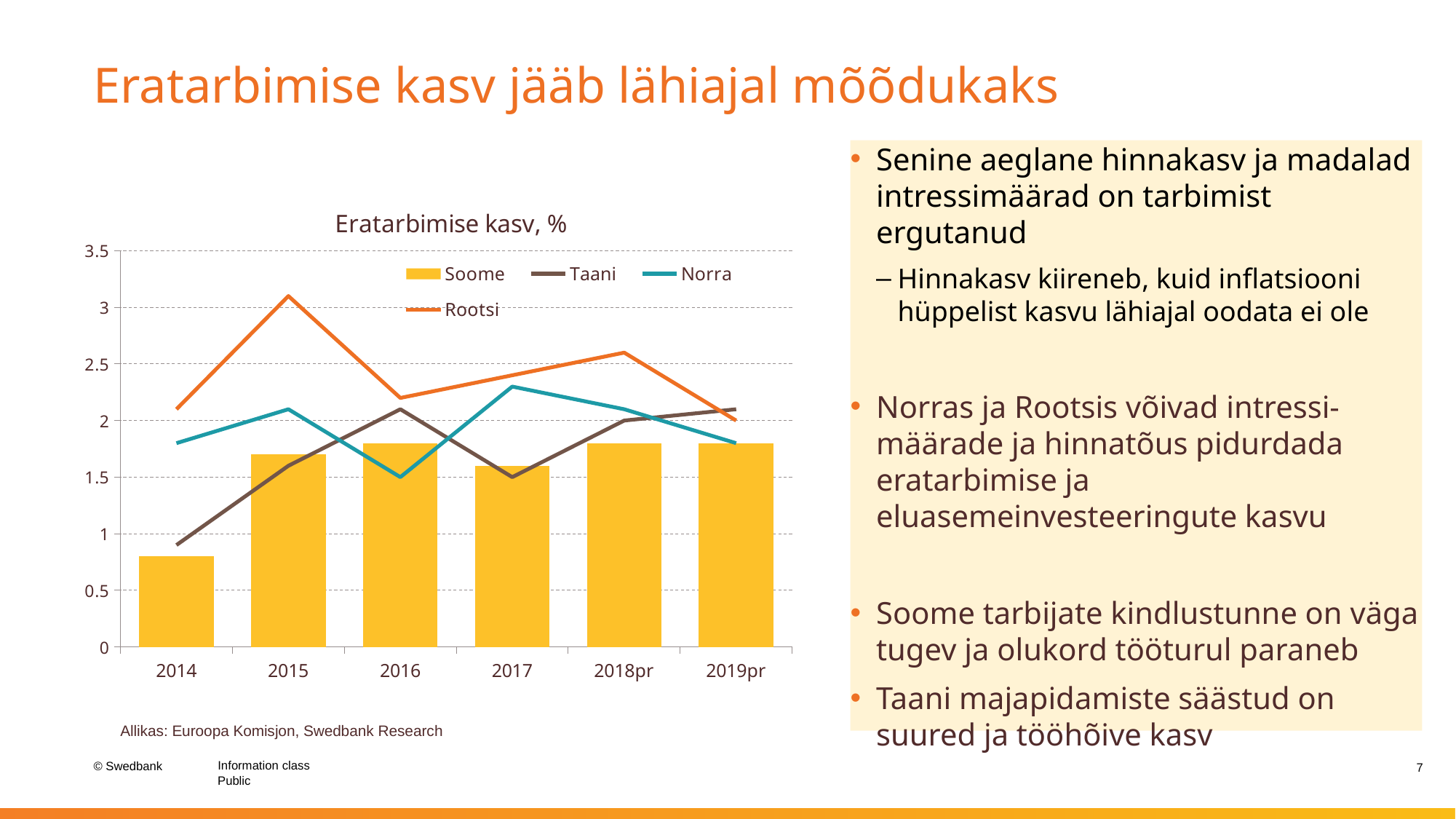
Is the value for Soome in 2014 greater or less than 1? less How many series does the chart legend list? 4 In 2015, which is larger: the value for Rootsi or the value for Soome? Rootsi What is the title of the chart? Eratarbimise kasv, % How many years (categories) are shown on the x axis of the chart? 6 Is the value for Norra in 2017 greater or less than 2? greater In which year does the Rootsi line reach its highest value? 2015 Does the Rootsi line rise or fall from 2015 to 2016? fall Is the value for Taani in 2014 greater or less than 1.5? less Which series in the chart is drawn as bars rather than a line? Soome In which year is the Soome bar lowest? 2014